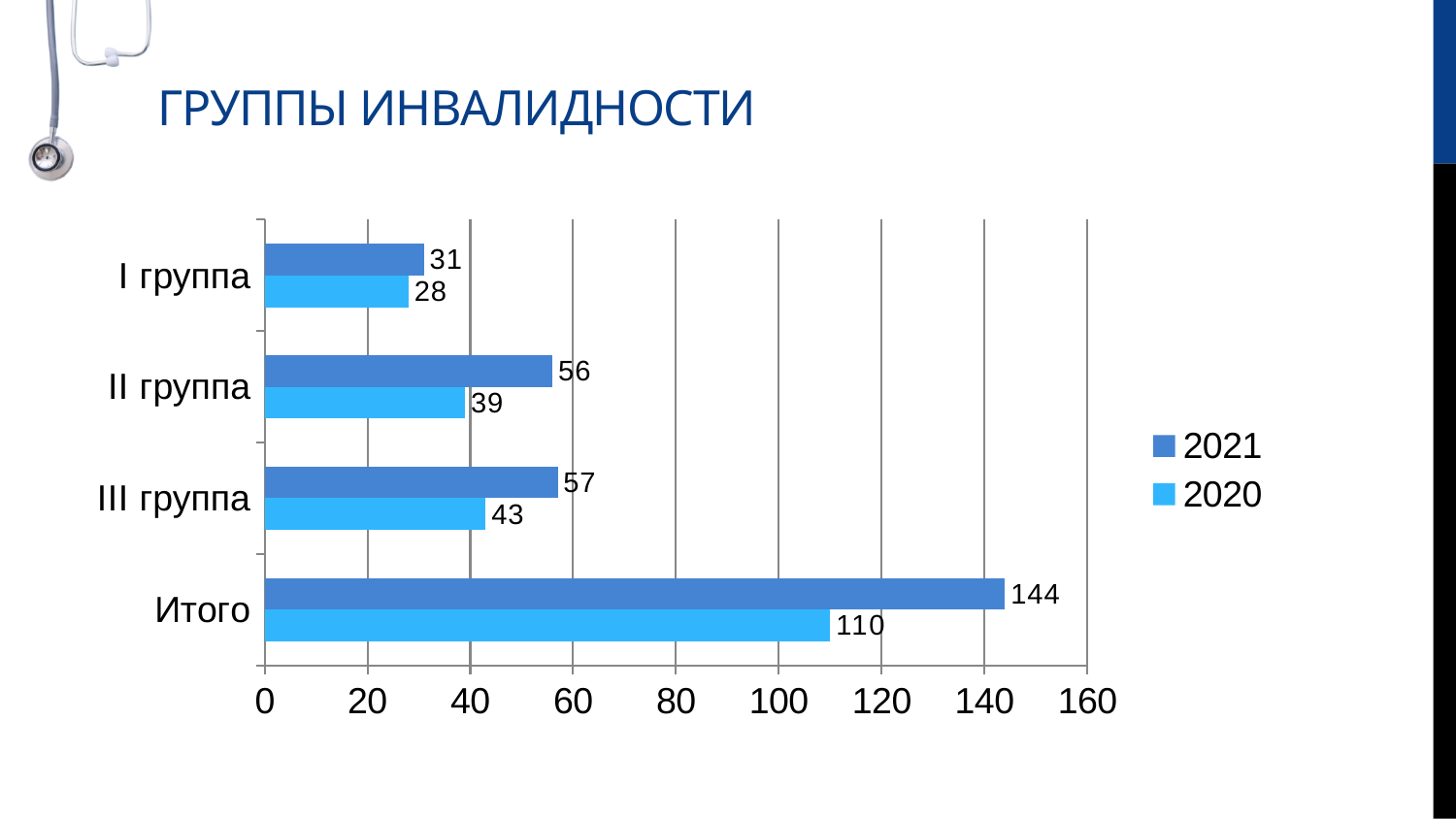
What is the value for Итого in 2021? 144 What is the difference between the 2021 and 2020 values for Итого? 34 Which category has the lowest value in 2020? I группа What is the value for I группа in 2020? 28 Which is larger: the 2020 value for II группа or the 2020 value for III группа? III группа What is the value for III группа in 2020? 43 How many series does the legend list? 2 How many categories are shown on the y axis? 4 What kind of chart is shown on the slide? bar chart What is the value for II группа in 2021? 56 Among I группа, II группа and III группа, which has the highest value in 2021? III группа What is the difference between the 2021 and 2020 values for II группа? 17